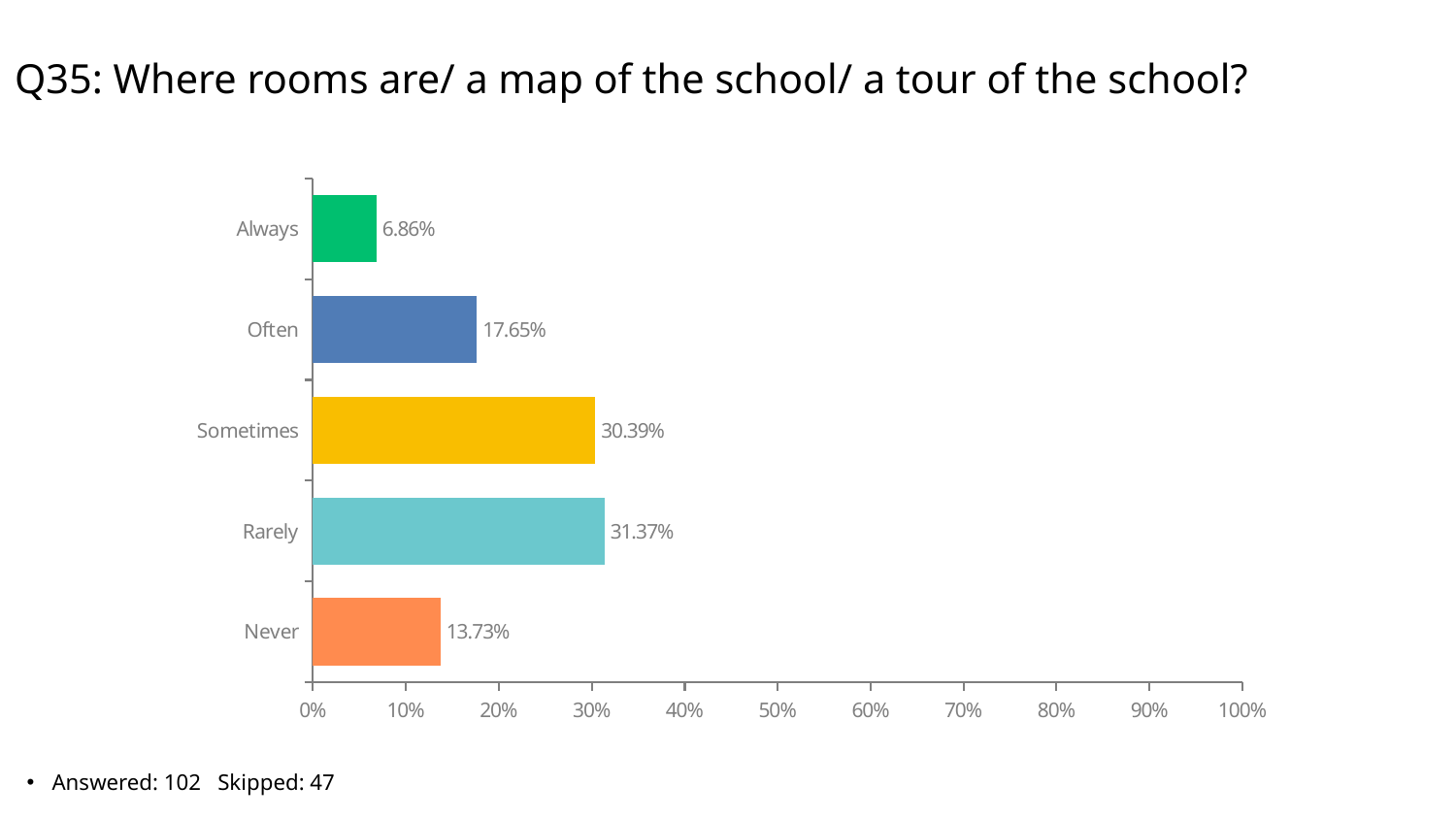
Which response category has the lowest percentage? Always Which is larger, the value for "Often" or the value for "Never"? Often Which response category has the highest percentage? Rarely What type of chart is shown on the slide? Bar chart What percentage of respondents answered "Always"? 6.86% What percentage is shown for "Never"? 13.73% What is the value for "Sometimes"? 30.39% What is the value shown for "Rarely"? 31.37% What is the difference between the values for "Sometimes" and "Often"? 12.74% What is the difference between the values for "Often" and "Always"? 10.79% Is the value for "Often" greater or less than 20%? less How many response categories are shown in the chart? 5